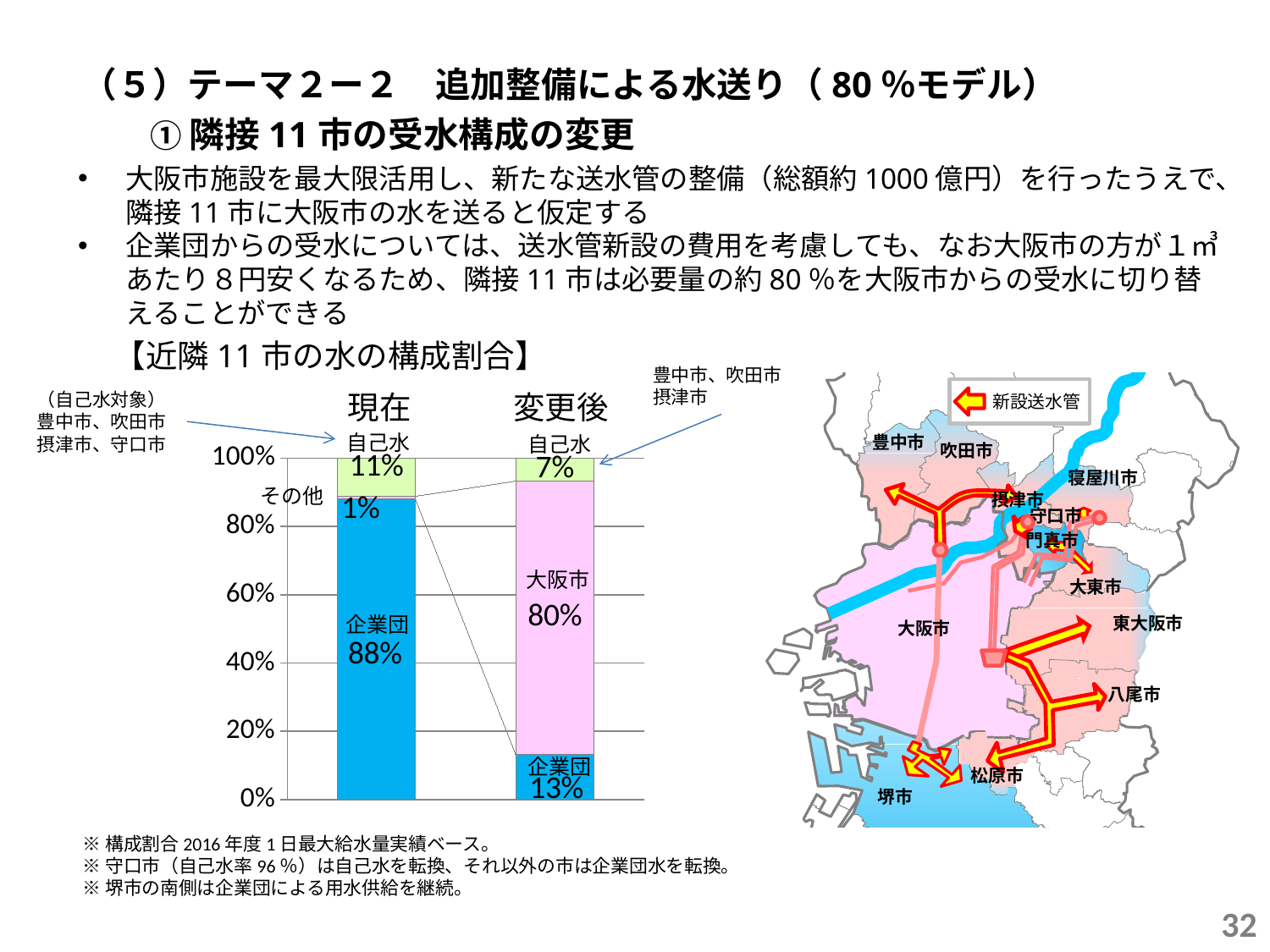
In the stacked bar chart, what is the 自己水 share in the 変更後 bar? 7% In the stacked bar chart, which segment is the smallest in the 現在 bar? その他 What kind of chart is used to show 【近隣11市の水の構成割合】? Stacked bar chart How many stacked bars does the chart 【近隣11市の水の構成割合】 show? 2 In the stacked bar chart, what percentage does 大阪市 account for in the 変更後 bar? 80% In the stacked bar chart, is the 自己水 share larger in the 現在 bar or the 変更後 bar? 現在 In the stacked bar chart 【近隣11市の水の構成割合】, what percentage does 企業団 account for in the 現在 bar? 88% In the stacked bar chart, by how many percentage points does the 企業団 share fall from 現在 to 変更後? 75 percentage points In the stacked bar chart, which segment is the largest in the 変更後 bar? 大阪市 In the stacked bar chart, what is the その他 share in the 現在 bar? 1% In the stacked bar chart, what is the 企業団 share in the 変更後 bar? 13% In the stacked bar chart, what is the 自己水 share in the 現在 bar? 11%